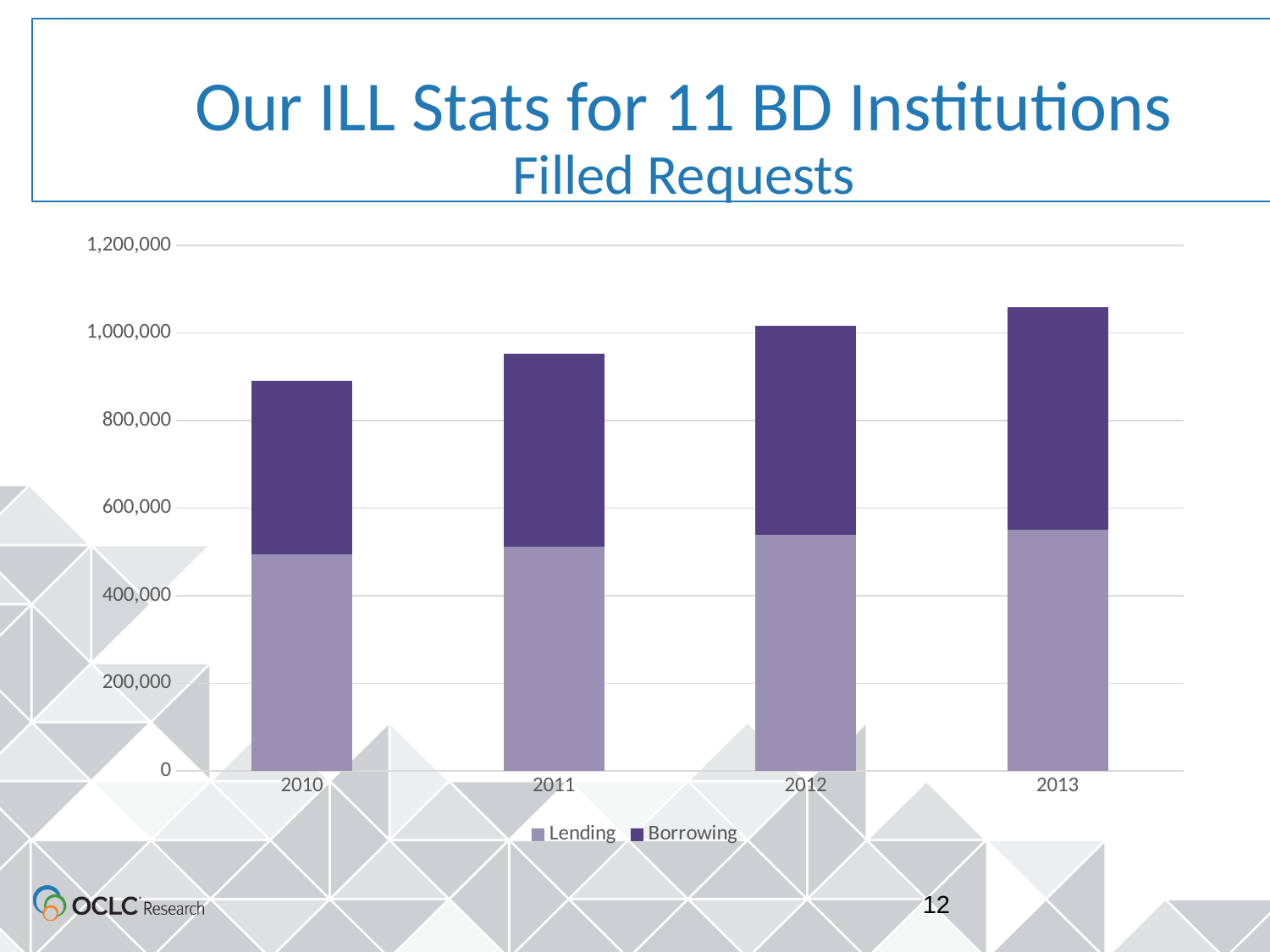
Is the total stacked bar for 2013 greater or less than 1,000,000? greater How many series does the chart's legend list? 2 Which two series are listed in the chart's legend? Lending and Borrowing Which year has the tallest stacked bar (highest total filled requests)? 2013 What kind of chart is shown on the slide? Stacked bar chart Is the Lending value for 2010 greater or less than 600,000? less Do the total filled requests rise or fall from 2010 to 2013? Rise Is the Lending value for 2012 greater or less than 400,000? greater How many years are shown on the x axis of the chart? 4 Which year has the shortest stacked bar (lowest total filled requests)? 2010 In 2010, which is larger, the Lending segment or the Borrowing segment? Lending